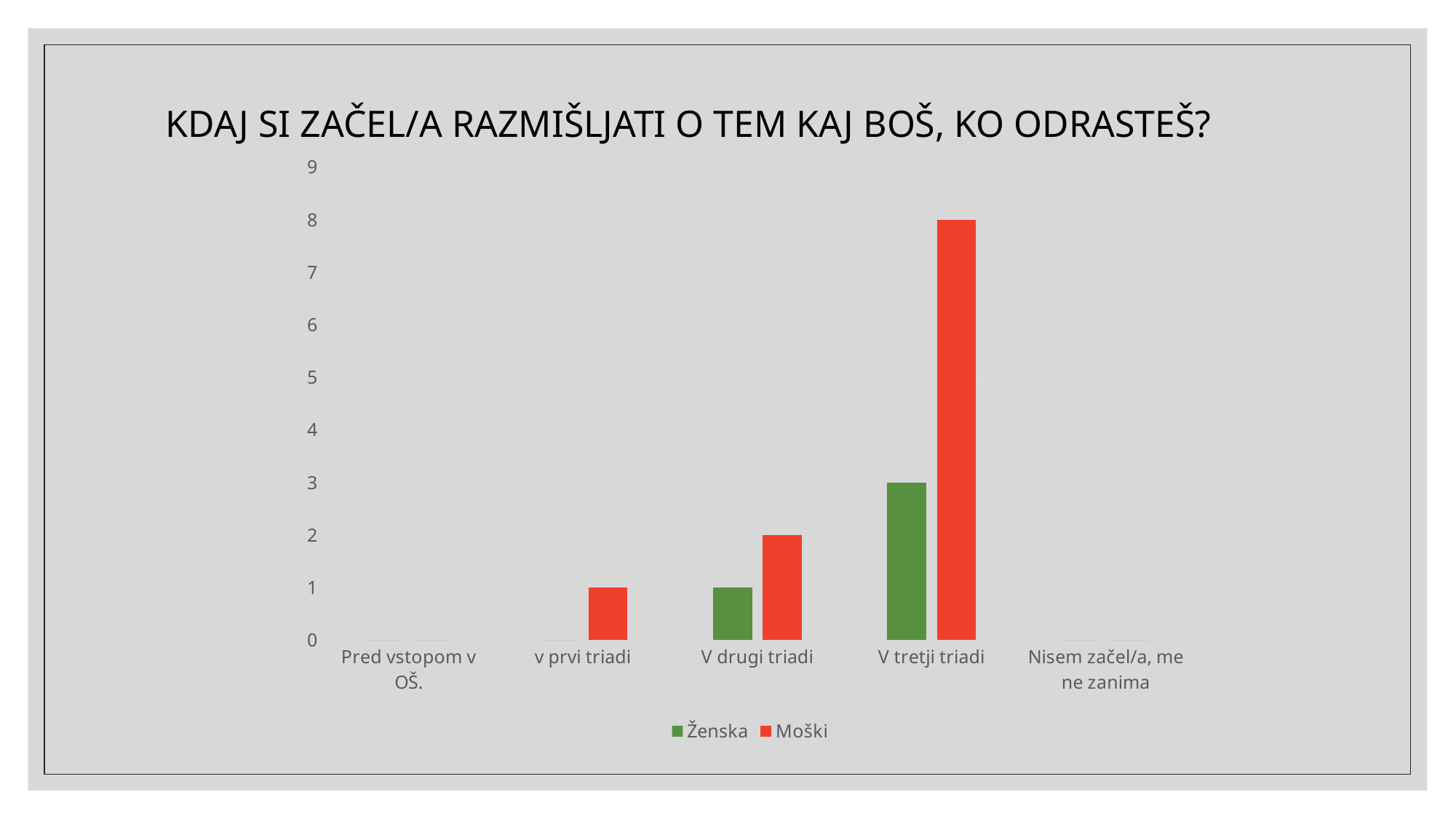
What is the value for Ženska in the category V tretji triadi? 3 What kind of chart is shown on the slide? bar chart What is the value for Moški in the category v prvi triadi? 1 What is the difference between the Moški and Ženska values in the category V tretji triadi? 5 Which series is shown in green in the legend? Ženska How many categories are shown on the x axis? 5 How many series does the legend list? 2 What is the value for Moški in the category V drugi triadi? 2 What is the value for Ženska in the category V drugi triadi? 1 What is the value for Moški in the category V tretji triadi? 8 In the category V drugi triadi, which series has the larger value, Ženska or Moški? Moški Which category has the highest value for Moški? V tretji triadi